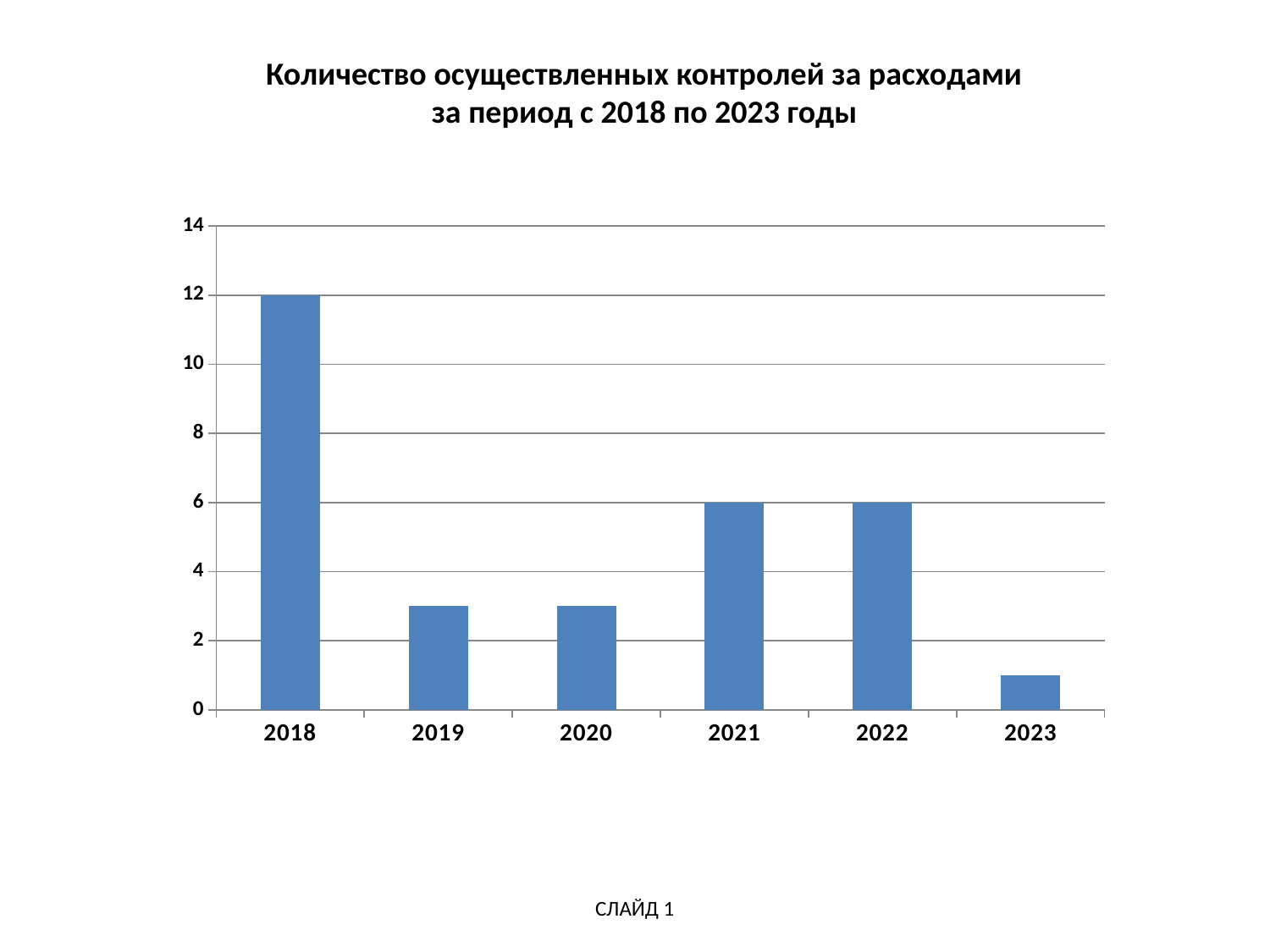
What is the value for 2022? 6 What is the value for 2018? 12 Which year has the lowest value? 2023 Which year has the highest value? 2018 What is the value for 2021? 6 Is the value for 2023 greater or less than 2? less Which is larger, the value for 2018 or the value for 2022? 2018 Is the value for 2019 greater or less than 4? less What is the title of the chart? Количество осуществленных контролей за расходами за период с 2018 по 2023 годы How many years are shown on the x axis? 6 What is the difference between the values for 2018 and 2021? 6 What kind of chart is shown on the slide? bar chart